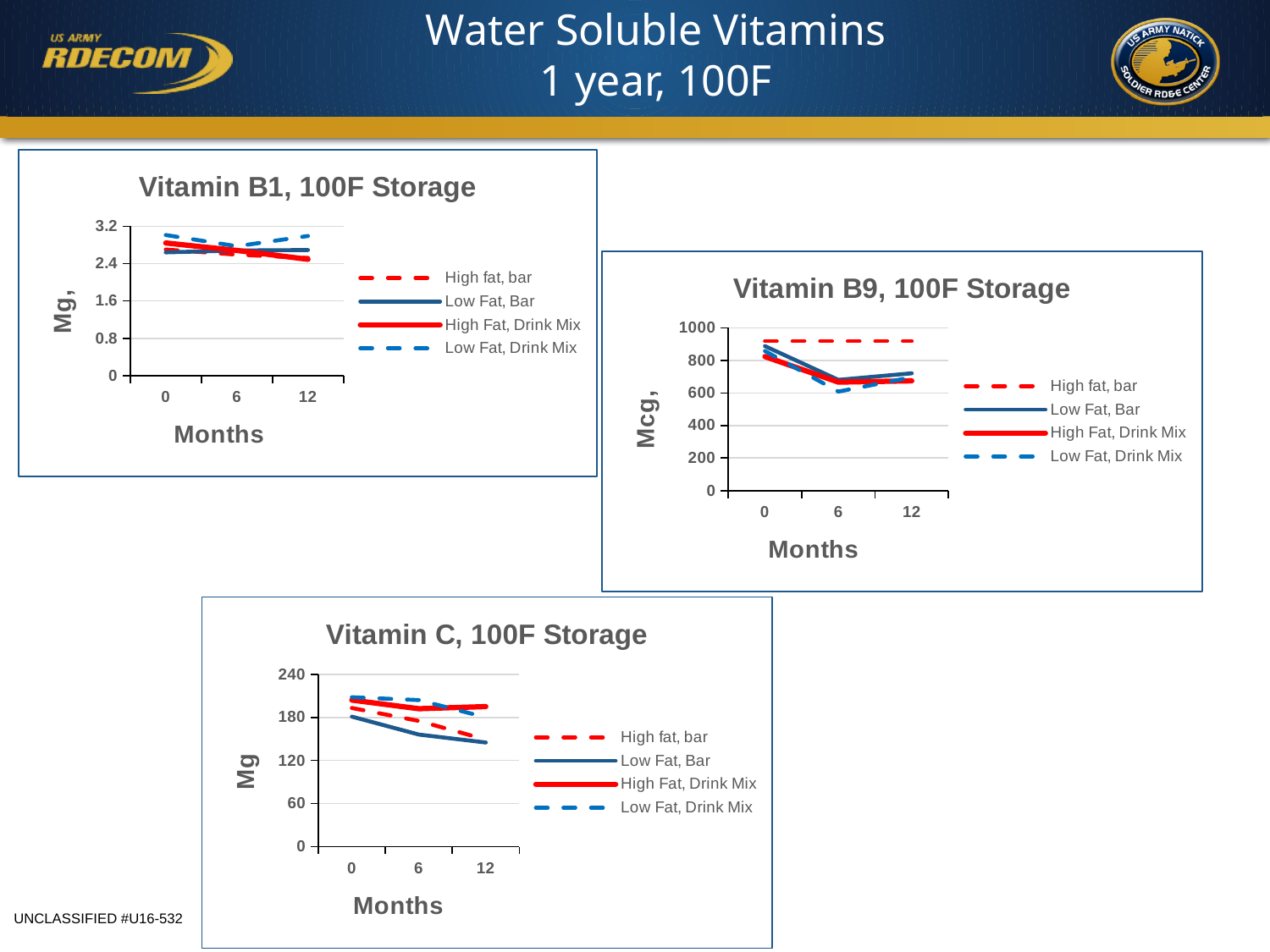
What is the y-axis label of the Vitamin B9, 100F Storage chart? Mcg, In the Vitamin C, 100F Storage chart, is the value for High Fat, Drink Mix at 0 months greater or less than 180? greater What is the x-axis label of the Vitamin C, 100F Storage chart? Months In the Vitamin C, 100F Storage chart, does the Low Fat, Bar series rise or fall from 0 to 12 months? fall In the Vitamin B1, 100F Storage chart, is the value for Low Fat, Drink Mix at 12 months greater or less than 2.4? greater In the Vitamin B9, 100F Storage chart, is the value for Low Fat, Drink Mix at 6 months greater or less than 800? less What kind of chart is the Vitamin B1, 100F Storage chart? line chart How many time points are plotted along the x axis of the Vitamin C, 100F Storage chart? 3 How many series does the legend of the Vitamin B9, 100F Storage chart list? 4 In the Vitamin B9, 100F Storage chart, does the Low Fat, Bar series rise or fall from 0 to 6 months? fall